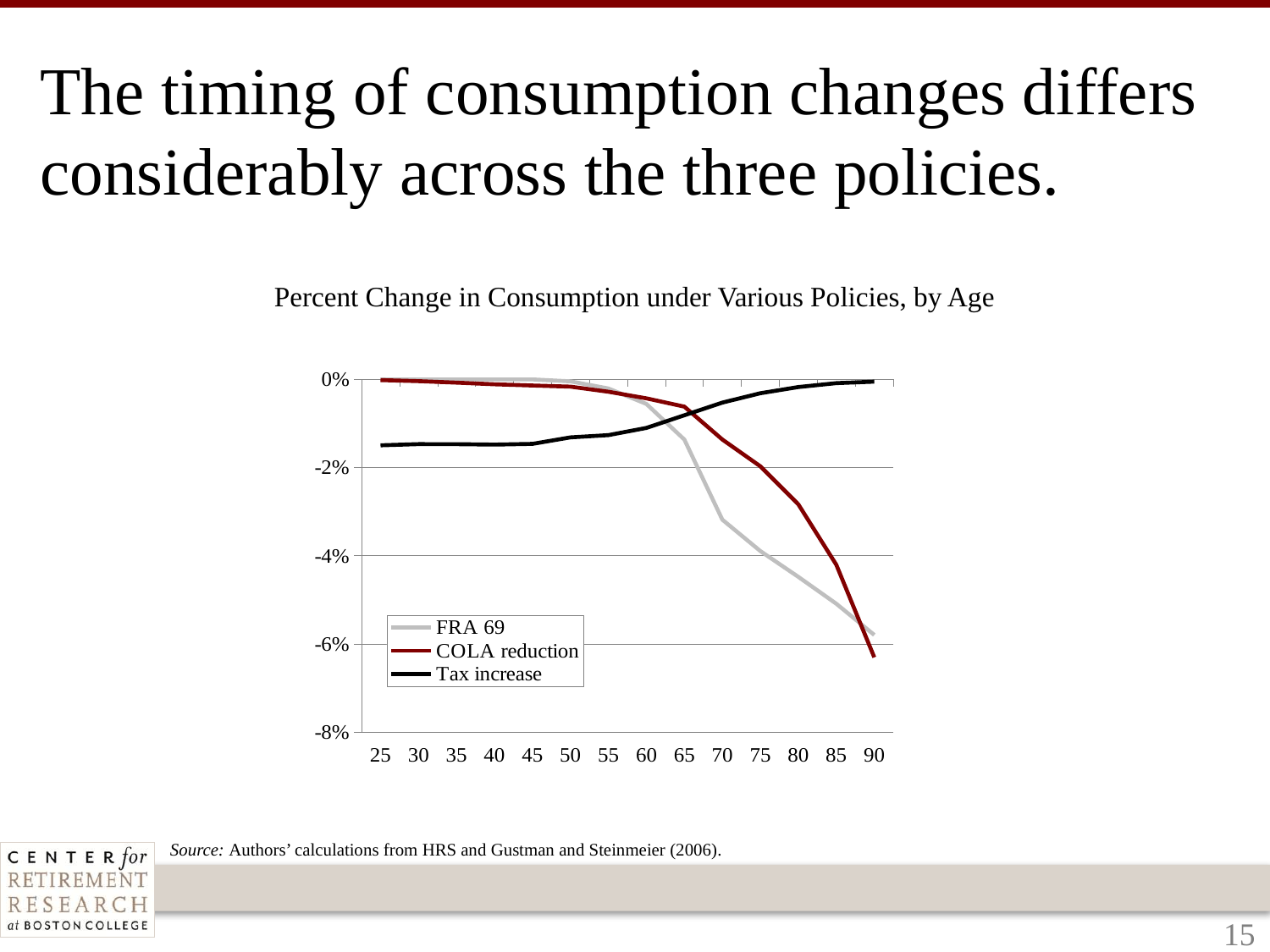
Which series is drawn in dark red? COLA reduction How many series does the legend list? 3 Does the FRA 69 line rise or fall as age increases from 50 to 90? Fall At age 70, which series has the lower value, FRA 69 or COLA reduction? FRA 69 Is the value for Tax increase at age 25 greater or less than -2%? greater What is the title of the chart? Percent Change in Consumption under Various Policies, by Age At age 25, which series has the lower value, Tax increase or FRA 69? Tax increase Is the value for FRA 69 at age 90 greater or less than -4%? less Does the Tax increase line rise or fall as age increases from 25 to 90? Rise What kind of chart is shown on the slide? Line chart How many age points are labelled along the x axis? 14 Is the value for COLA reduction at age 80 greater or less than -2%? less